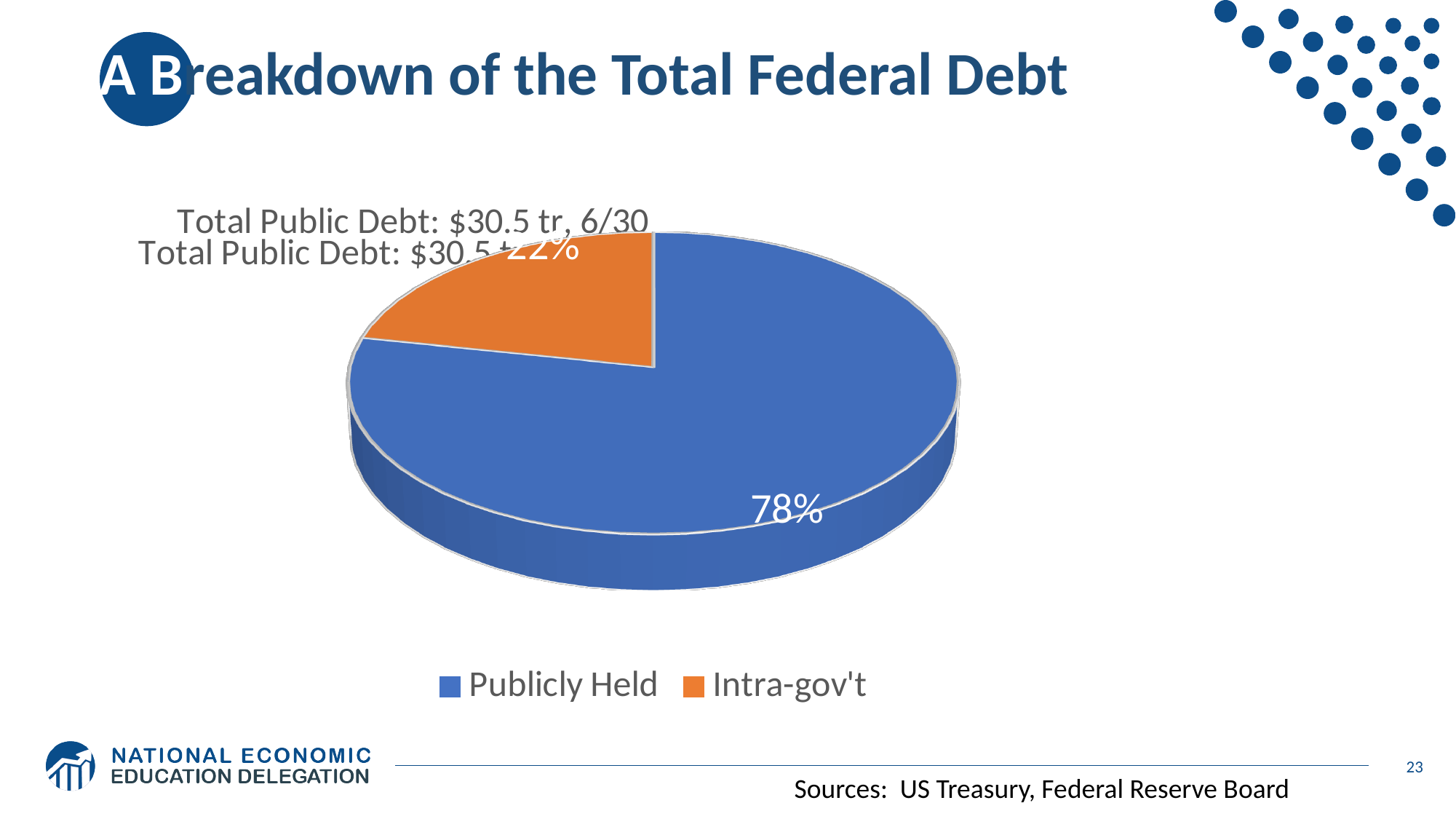
What total public debt figure is stated in the chart title? $30.5 tr By how many percentage points does the Publicly Held share exceed the Intra-gov't share? 56 Which slice of the pie is the largest? Publicly Held How many slices does the pie chart have? 2 Which slice of the pie is the smallest? Intra-gov't What colour is the Intra-gov't slice? orange Which is larger, the Publicly Held share or the Intra-gov't share? Publicly Held Is the Publicly Held share greater or less than 50%? greater What share of the total federal debt is Publicly Held? 78% How many entries does the legend list? 2 What kind of chart is shown on the slide? pie chart What share of the total federal debt is Intra-gov't? 22%